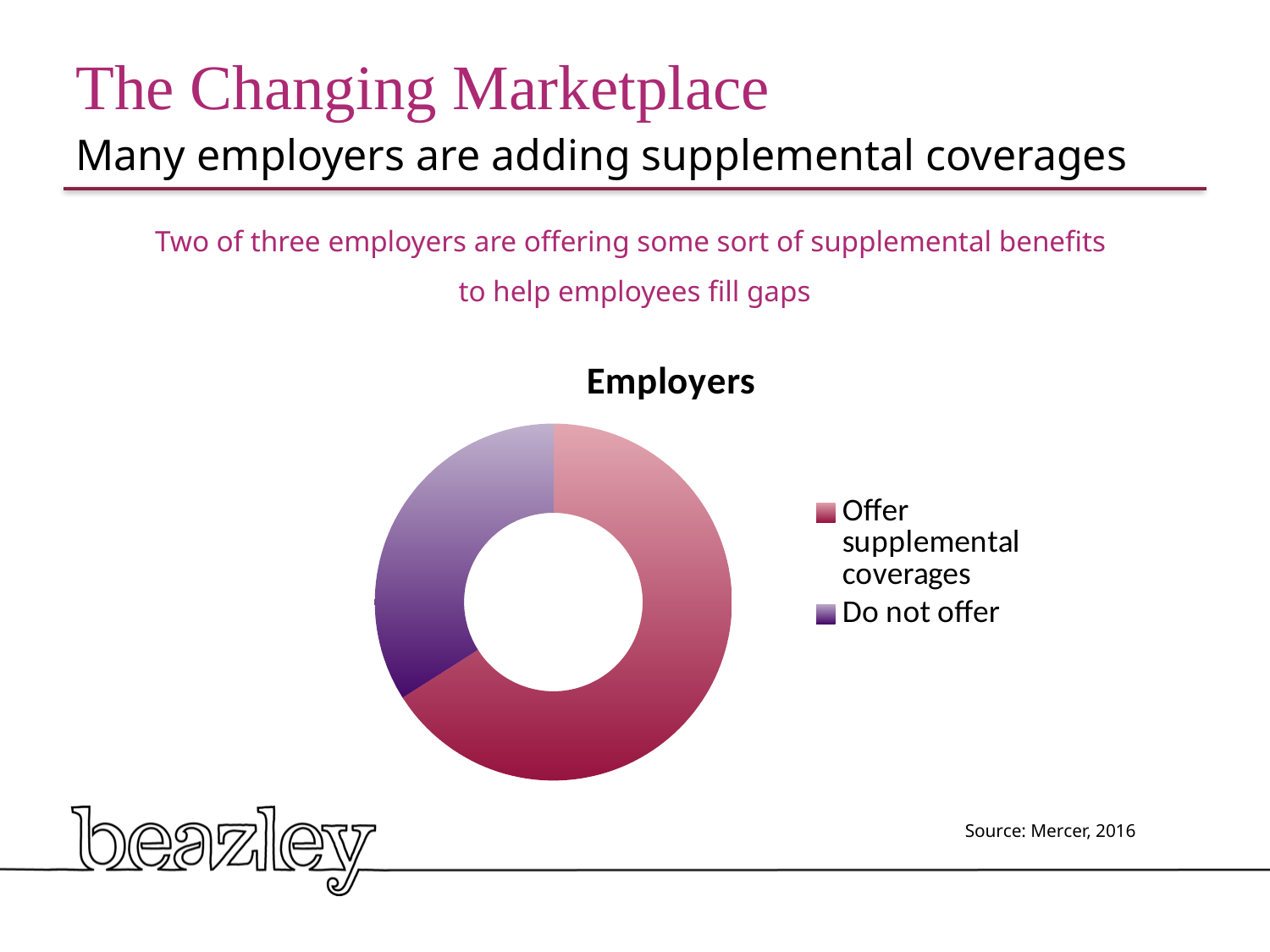
Which category has the smallest share of the chart? Do not offer How many categories does the chart show? 2 How many entries does the chart's legend list? 2 Which category has the largest share of the chart? Offer supplemental coverages Is the share for Do not offer greater or less than half of the chart? less Is the share for Offer supplemental coverages greater or less than half of the chart? greater What kind of chart is shown on the slide? doughnut chart Which is larger: the share for Offer supplemental coverages or the share for Do not offer? Offer supplemental coverages What is the title of the chart? Employers What colour represents the Do not offer category in the chart? purple